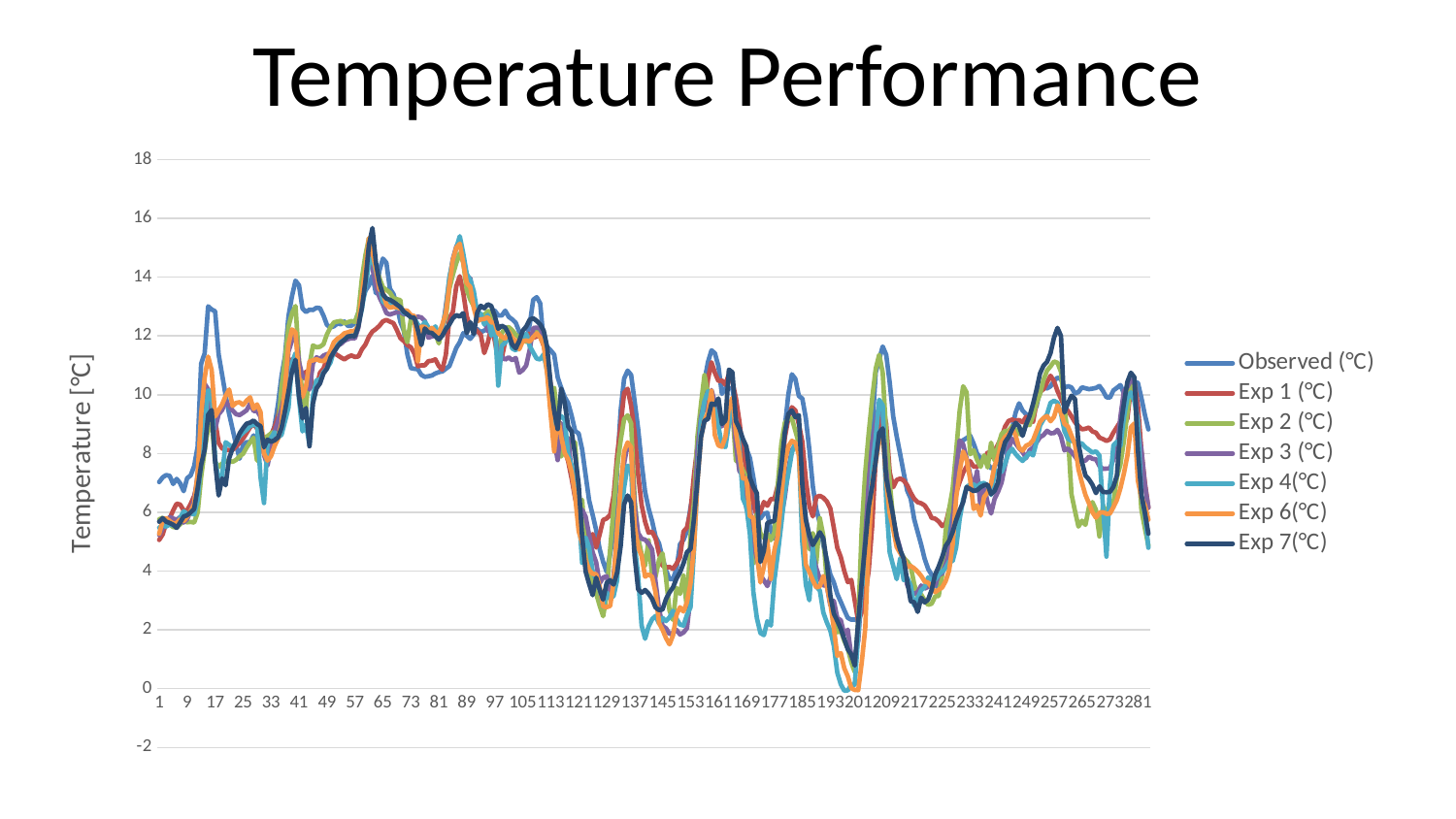
What is the title of the chart? Temperature Performance At x = 201, which is larger: the Observed (℃) line or the Exp 6(℃) line? Observed (℃) Is the value of the Observed (℃) line at x = 209 greater or less than 10? greater How many series does the legend list? 7 Is the value of the Observed (℃) line at x = 41 greater or less than 12? greater At x = 41, which is larger: the Observed (℃) line or the Exp 7(℃) line? Observed (℃) What kind of chart is shown on the slide? Line chart Is the value of the Exp 6(℃) line at x = 201 greater or less than 2? less What is the label on the vertical axis? Temperature [℃] Between x = 113 and x = 129, does the Observed (℃) line rise or fall? fall